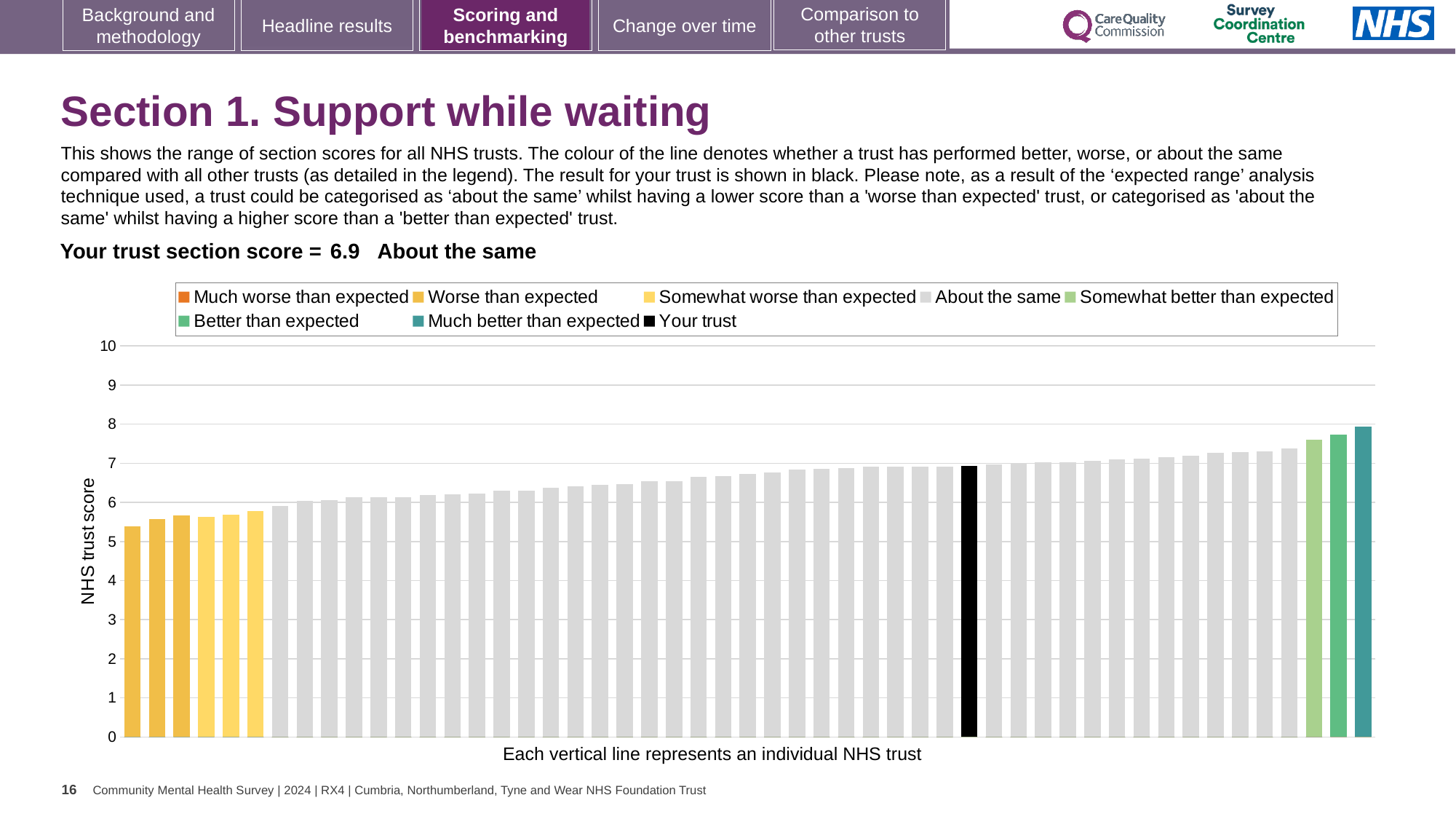
How many entries does the chart legend list? 8 How many bars are coloured as 'Much better than expected' (teal)? 1 What is the section score for your trust, as printed on the slide? 6.9 Is the value of the tallest bar greater or less than 7? greater Do the bar values rise or fall from left to right along the x axis? rise What kind of chart is shown on the slide? bar chart Is the value of the leftmost bar greater or less than 5? greater What colour is the bar representing your trust? black Which category is your trust placed in, according to the text above the chart? About the same Is the value of the black 'Your trust' bar greater or less than 6? greater What is the label on the vertical axis of the chart? NHS trust score